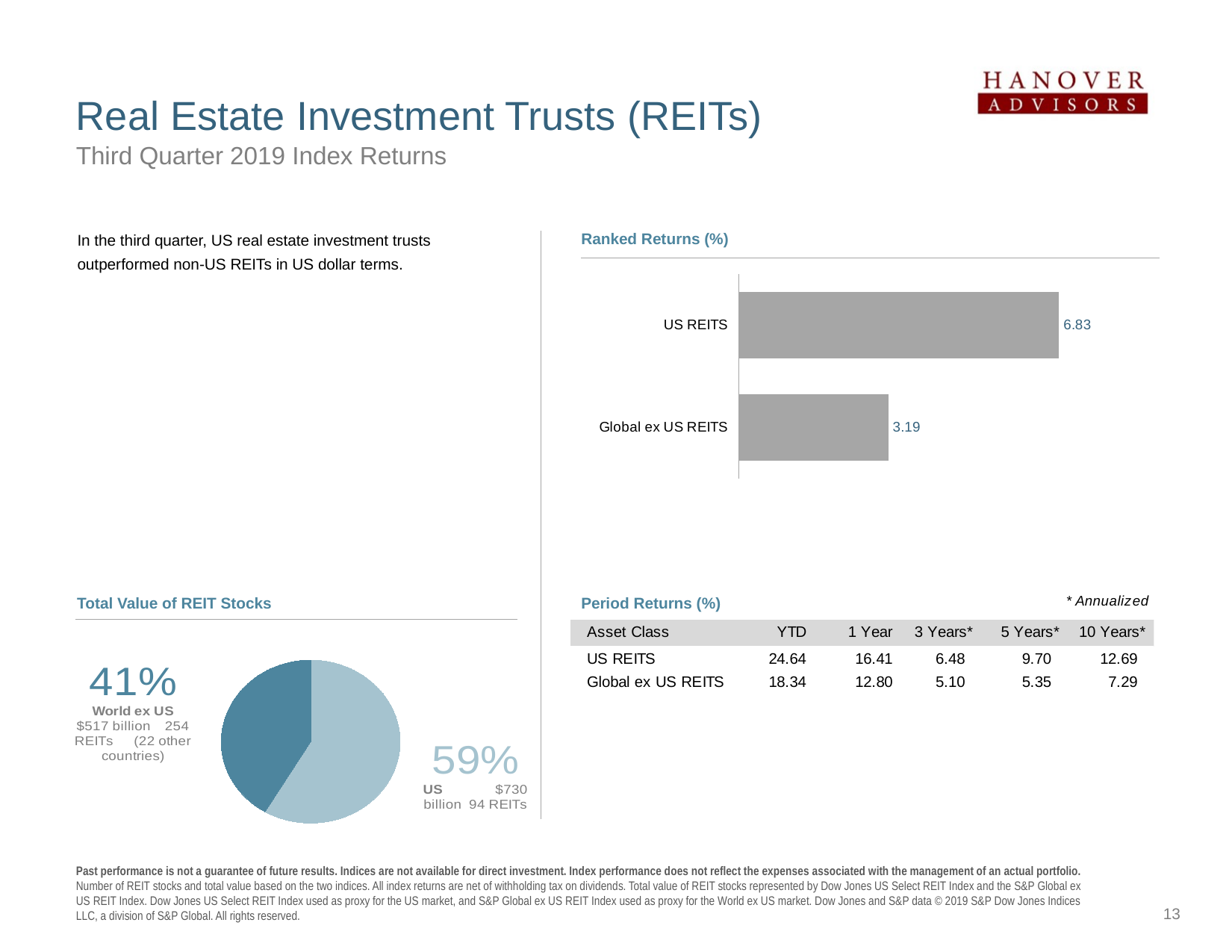
In the Total Value of REIT Stocks chart, what share of the pie is US? 59% In the Ranked Returns (%) chart, what is the difference between the US REITS and Global ex US REITS values? 3.64 In the Total Value of REIT Stocks chart, what share of the pie is World ex US? 41% What kind of chart is the Total Value of REIT Stocks chart? Pie chart In the Ranked Returns (%) chart, which category has the highest return? US REITS How many categories are shown in the Ranked Returns (%) chart? 2 In the Ranked Returns (%) chart, which is larger: US REITS or Global ex US REITS? US REITS In the Total Value of REIT Stocks chart, which slice is larger: US or World ex US? US What kind of chart is the Ranked Returns (%) chart? Bar chart In the Ranked Returns (%) chart, what is the value for US REITS? 6.83 In the Ranked Returns (%) chart, what is the value for Global ex US REITS? 3.19 In the Ranked Returns (%) chart, which category has the lowest return? Global ex US REITS